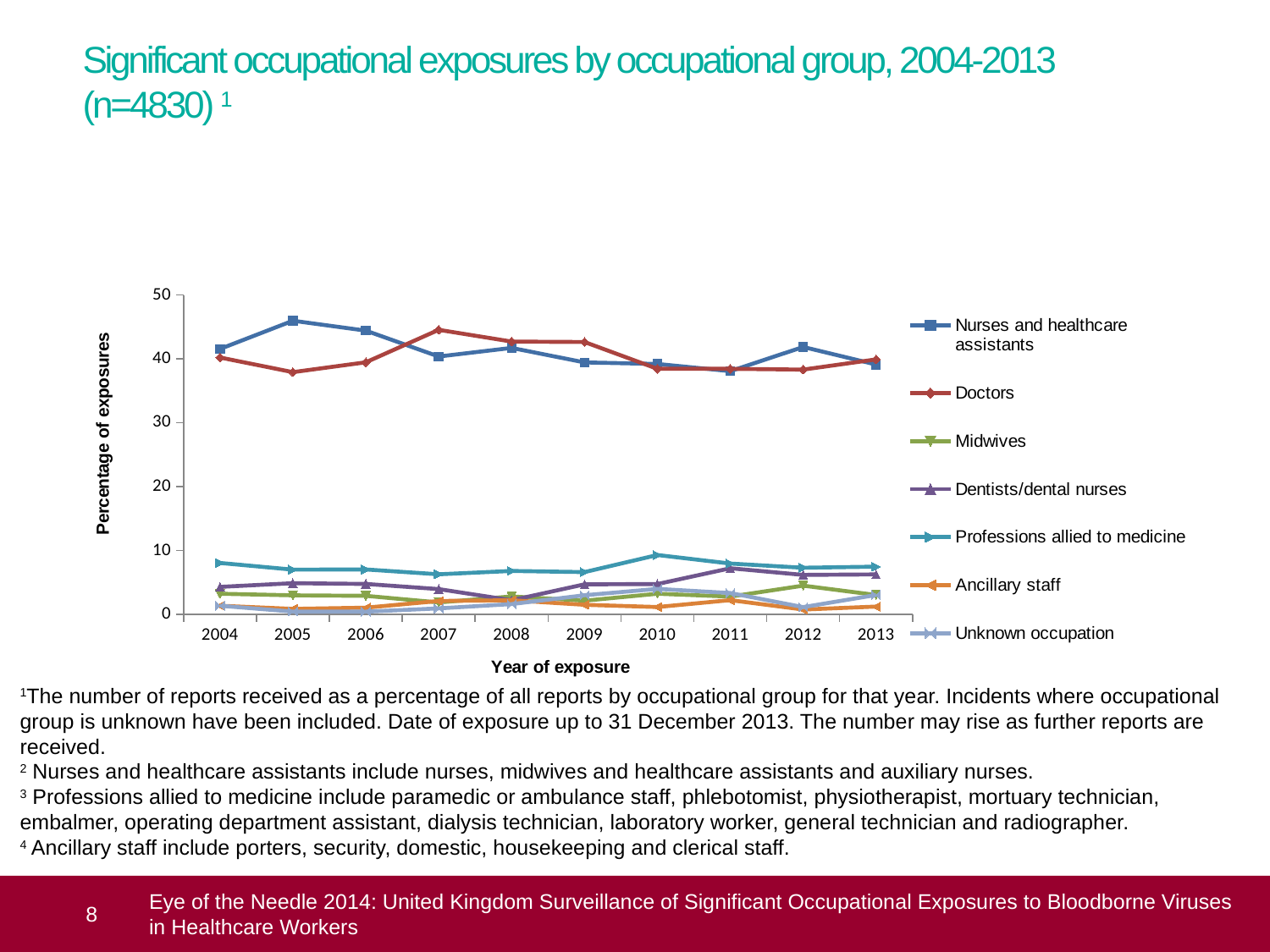
Does the value for Nurses and healthcare assistants rise or fall from 2005 to 2011? fall In 2007, which is larger: the value for Doctors or the value for Nurses and healthcare assistants? Doctors Is the value for Nurses and healthcare assistants in 2005 greater or less than 40? greater Which occupational group has the highest percentage of exposures in 2005? Nurses and healthcare assistants How many series does the legend list? 7 In which year is the value for Nurses and healthcare assistants highest? 2005 How many years are plotted along the x axis? 10 Which occupational group has the highest percentage of exposures in 2007? Doctors Is the value for Professions allied to medicine in 2004 greater or less than 10? less What kind of chart is shown on the slide? line chart What is the title of the y axis? Percentage of exposures Is the value for Doctors in 2005 greater or less than 40? less